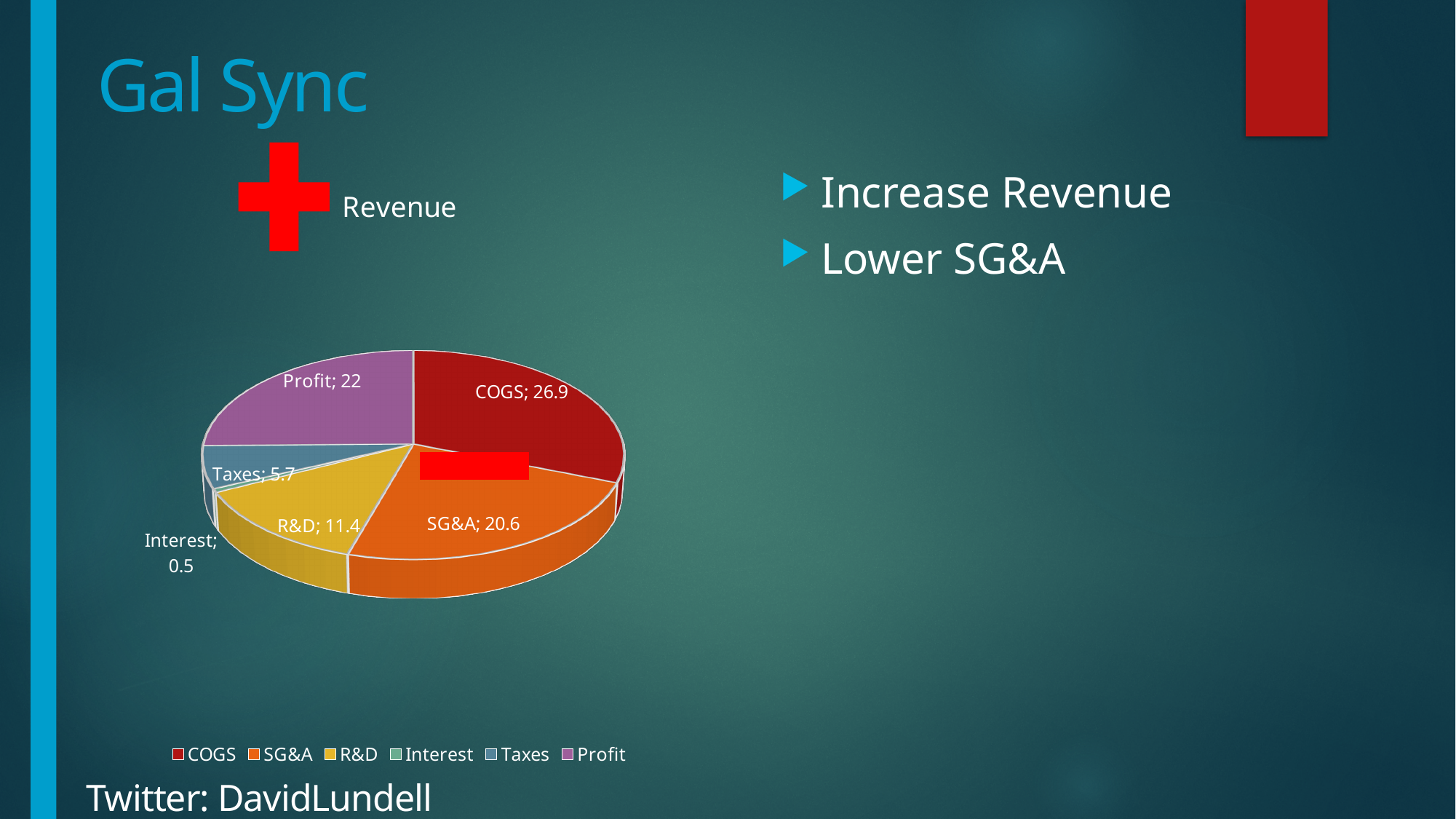
What value is shown for COGS in the pie chart? 26.9 What is the difference between the Profit value and the Taxes value? 16.3 What is the difference between the COGS value and the SG&A value? 6.3 What kind of chart is shown on the slide? Pie chart Which category has the smallest slice in the pie chart? Interest How many slices does the pie chart have? 6 What value is shown for SG&A in the pie chart? 20.6 What value is shown for Taxes in the pie chart? 5.7 What value is shown for Interest in the pie chart? 0.5 Which category has the largest slice in the pie chart? COGS Which entries are listed in the chart legend? COGS, SG&A, R&D, Interest, Taxes, Profit Which is larger, the value for Profit or the value for SG&A? Profit